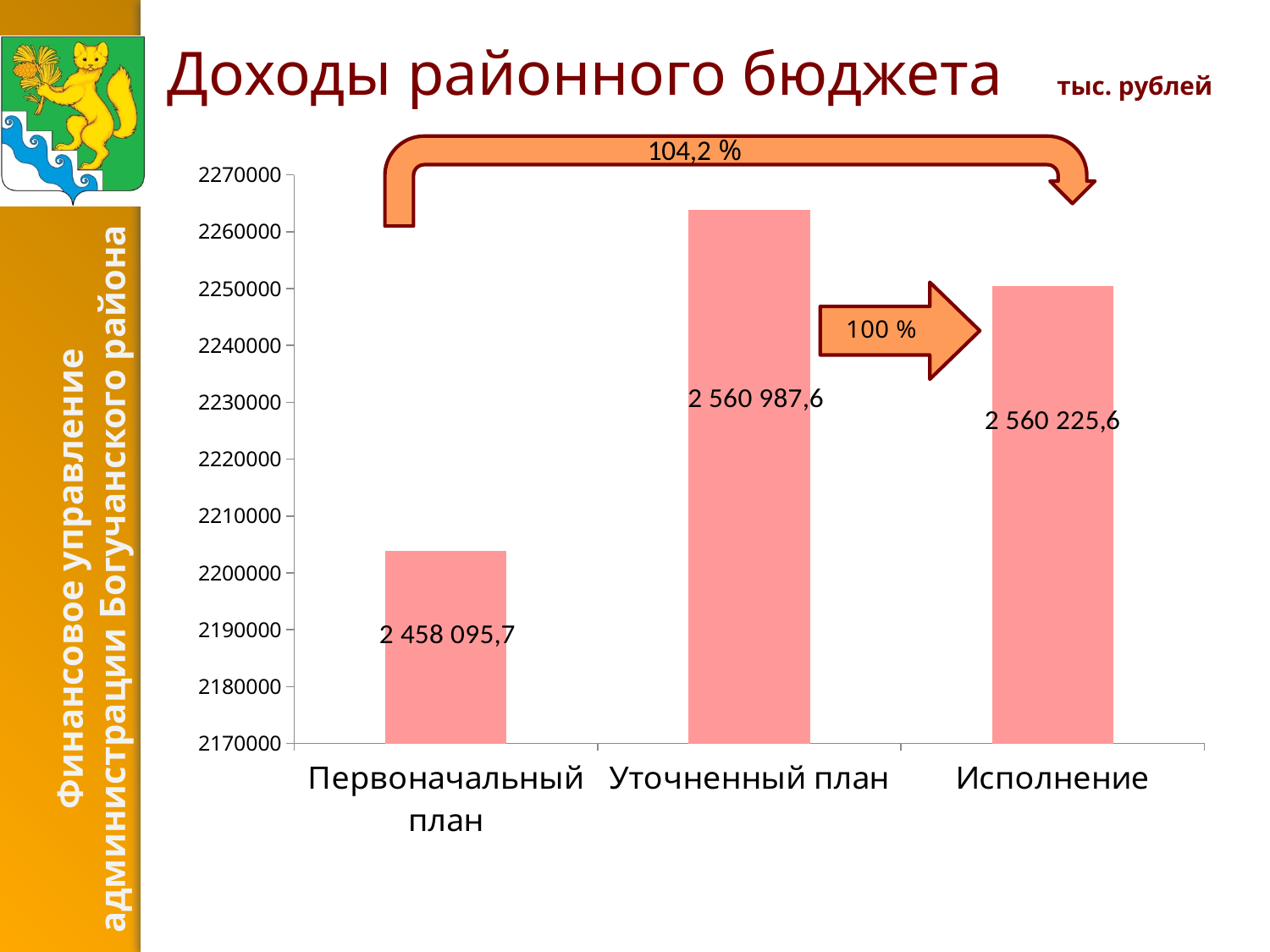
What is the value for Первоначальный план? 2 458 095,7 What is the title of the chart? Доходы районного бюджета How many categories are shown on the x axis? 3 What is the value for Исполнение? 2 560 225,6 What percentage is shown on the arrow from Первоначальный план to Исполнение? 104,2 % Which is larger, Первоначальный план or Исполнение? Исполнение Which category has the highest value? Уточненный план What is the difference between Уточненный план and Исполнение? 762 Which category has the lowest value? Первоначальный план What is the difference between Уточненный план and Первоначальный план? 102 891,9 What kind of chart is shown on the slide? Bar chart What is the value for Уточненный план? 2 560 987,6